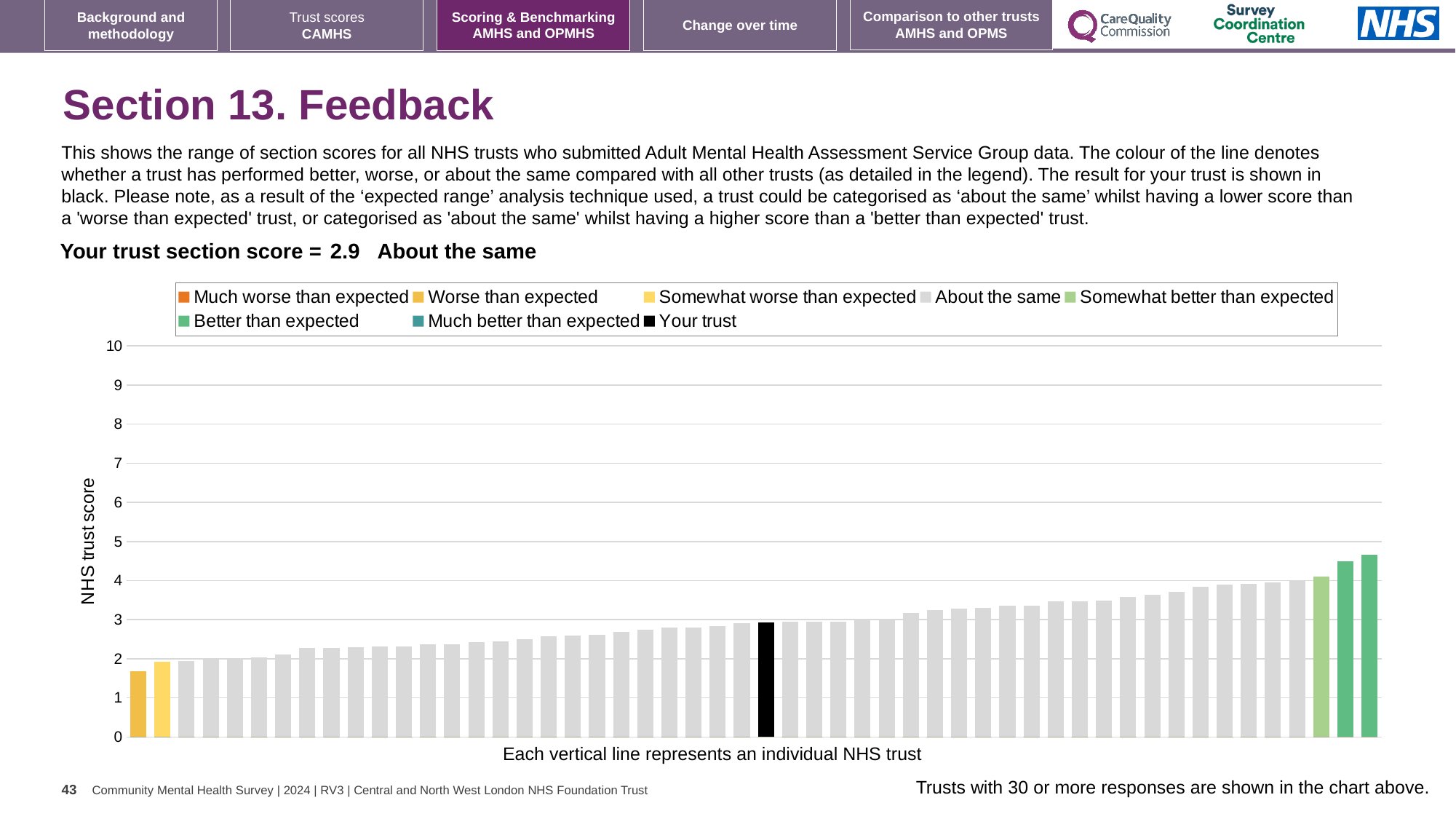
Is the value of the leftmost (shortest) bar greater or less than 2? less Which category is your trust's section score placed in? About the same Is the value of the black 'Your trust' bar greater or less than 2? greater What colour is used for the 'Your trust' bar in the chart? black What is the label on the vertical axis of the chart? NHS trust score How many entries does the chart legend list? 8 Is the value of the tallest bar in the chart greater or less than 4? greater What kind of chart is shown on the slide? bar chart What is the section score for your trust shown on the slide? 2.9 Do the bar values rise or fall from left to right along the x axis? rise Which legend category does the tallest bar in the chart belong to? Better than expected Which legend category does the shortest bar in the chart belong to? Worse than expected